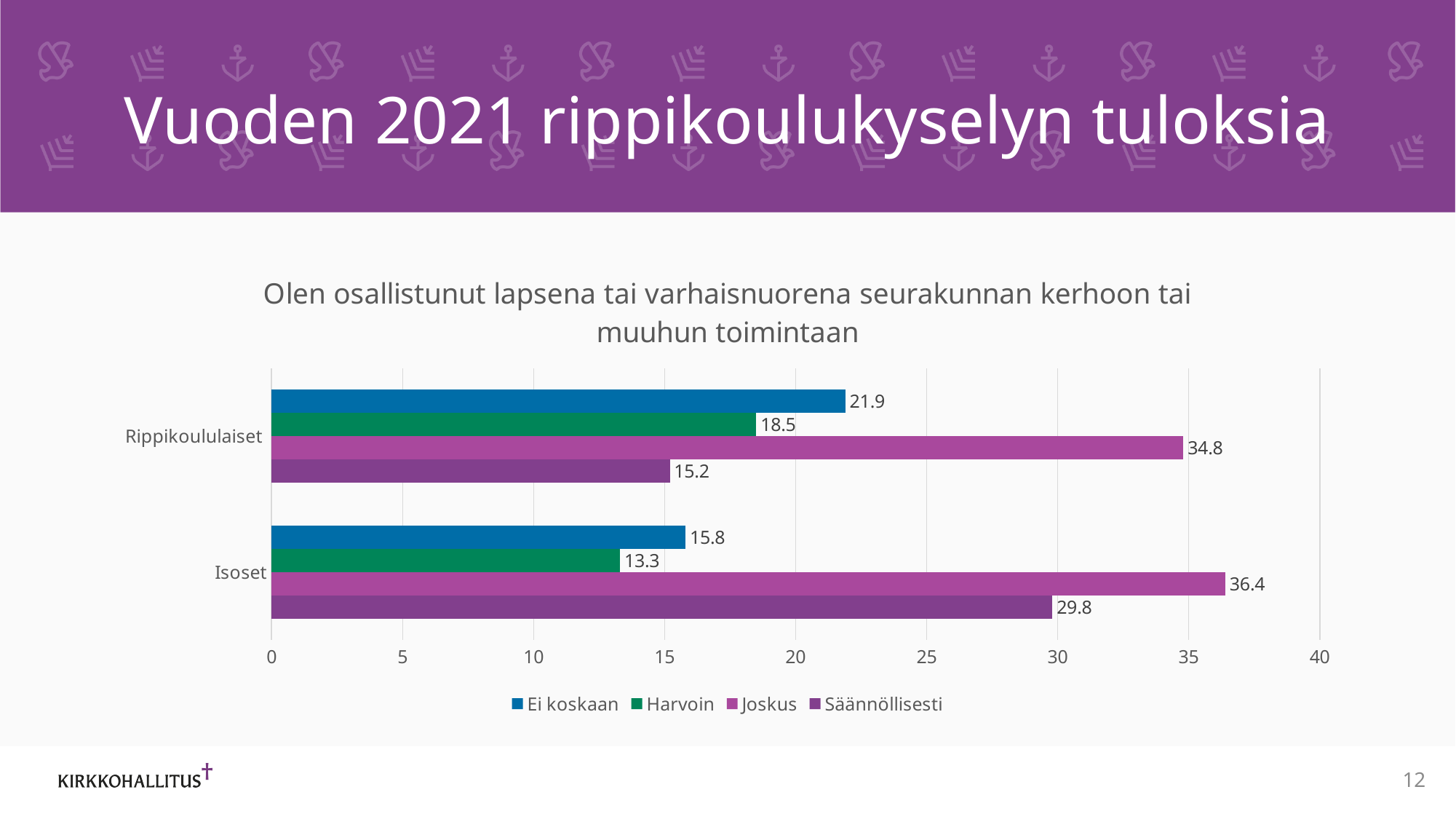
How many series does the legend list? 4 What is the value for Joskus in the Rippikoululaiset category? 34.8 What kind of chart is shown on the slide? Bar chart Is the value for Joskus in the Isoset category greater or less than 35? greater What is the value for Säännöllisesti in the Isoset category? 29.8 Which series has the lowest value in the Rippikoululaiset category? Säännöllisesti Which is larger: Ei koskaan for Rippikoululaiset or Ei koskaan for Isoset? Rippikoululaiset What is the value for Ei koskaan in the Isoset category? 15.8 What is the difference between the Säännöllisesti values for Isoset and Rippikoululaiset? 14.6 What is the value for Harvoin in the Rippikoululaiset category? 18.5 Which series has the highest value in the Isoset category? Joskus How many categories are shown on the y axis? 2